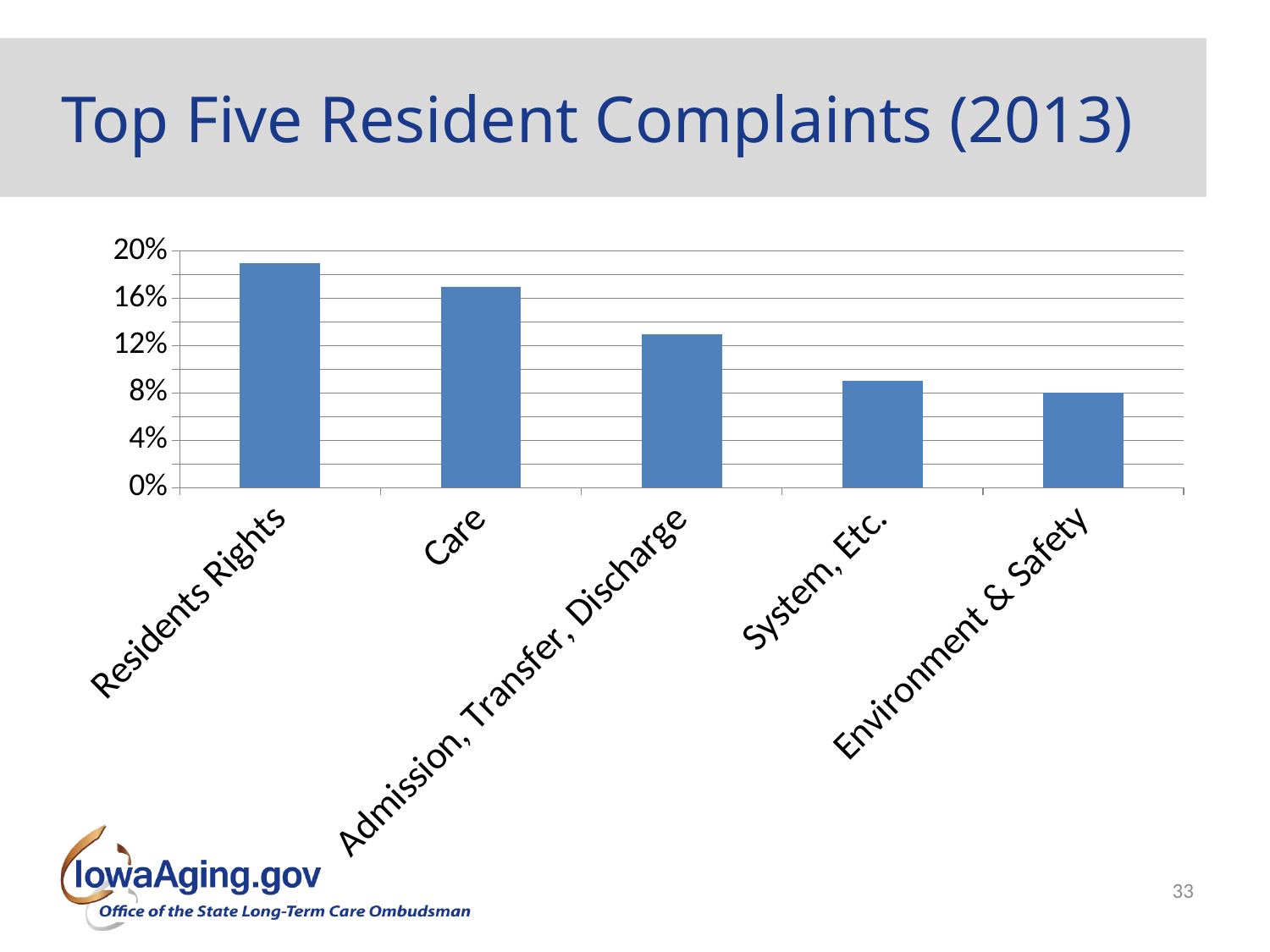
How many complaint categories are shown in the chart? 5 Is the value for Admission, Transfer, Discharge greater or less than 8%? greater Which is larger, the value for Care or the value for Admission, Transfer, Discharge? Care Do the values rise or fall moving from left to right along the x axis? fall Is the value for System, Etc. greater or less than 12%? less Which is larger, the value for Residents Rights or the value for Care? Residents Rights Which complaint category has the highest value? Residents Rights What kind of chart is shown on the slide? bar chart What is the title of the slide containing the chart? Top Five Resident Complaints (2013) Which complaint category has the lowest value? Environment & Safety Is the value for Care greater or less than 20%? less